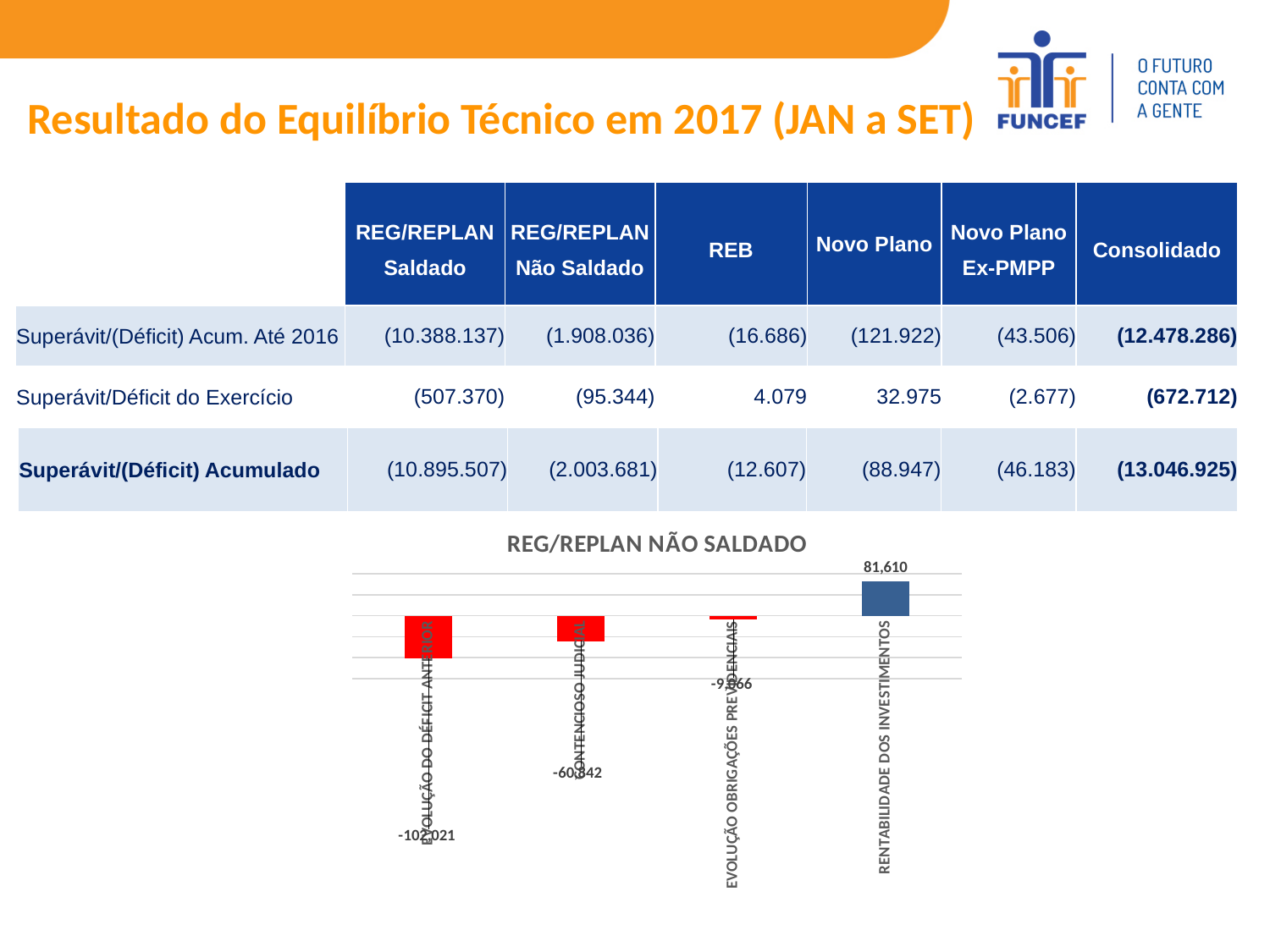
In the REG/REPLAN NÃO SALDADO chart, what colour is the bar for RENTABILIDADE DOS INVESTIMENTOS? blue What kind of chart is shown under the table? bar chart What is the title of the chart on the slide? REG/REPLAN NÃO SALDADO In the REG/REPLAN NÃO SALDADO chart, which category has the lowest value? EVOLUÇÃO DO DÉFICIT ANTERIOR In the REG/REPLAN NÃO SALDADO chart, which is larger: the value for CONTENCIOSO JUDICIAL or the value for EVOLUÇÃO OBRIGAÇÕES PREVIDENCIAIS? EVOLUÇÃO OBRIGAÇÕES PREVIDENCIAIS In the REG/REPLAN NÃO SALDADO chart, what is the value for EVOLUÇÃO OBRIGAÇÕES PREVIDENCIAIS? -9,066 In the REG/REPLAN NÃO SALDADO chart, what is the value for CONTENCIOSO JUDICIAL? -60,842 In the REG/REPLAN NÃO SALDADO chart, how many categories have negative values? 3 How many categories does the REG/REPLAN NÃO SALDADO chart show? 4 In the REG/REPLAN NÃO SALDADO chart, what is the value for EVOLUÇÃO DO DÉFICIT ANTERIOR? -102,021 In the REG/REPLAN NÃO SALDADO chart, what is the value for RENTABILIDADE DOS INVESTIMENTOS? 81,610 In the REG/REPLAN NÃO SALDADO chart, which category has the highest value? RENTABILIDADE DOS INVESTIMENTOS